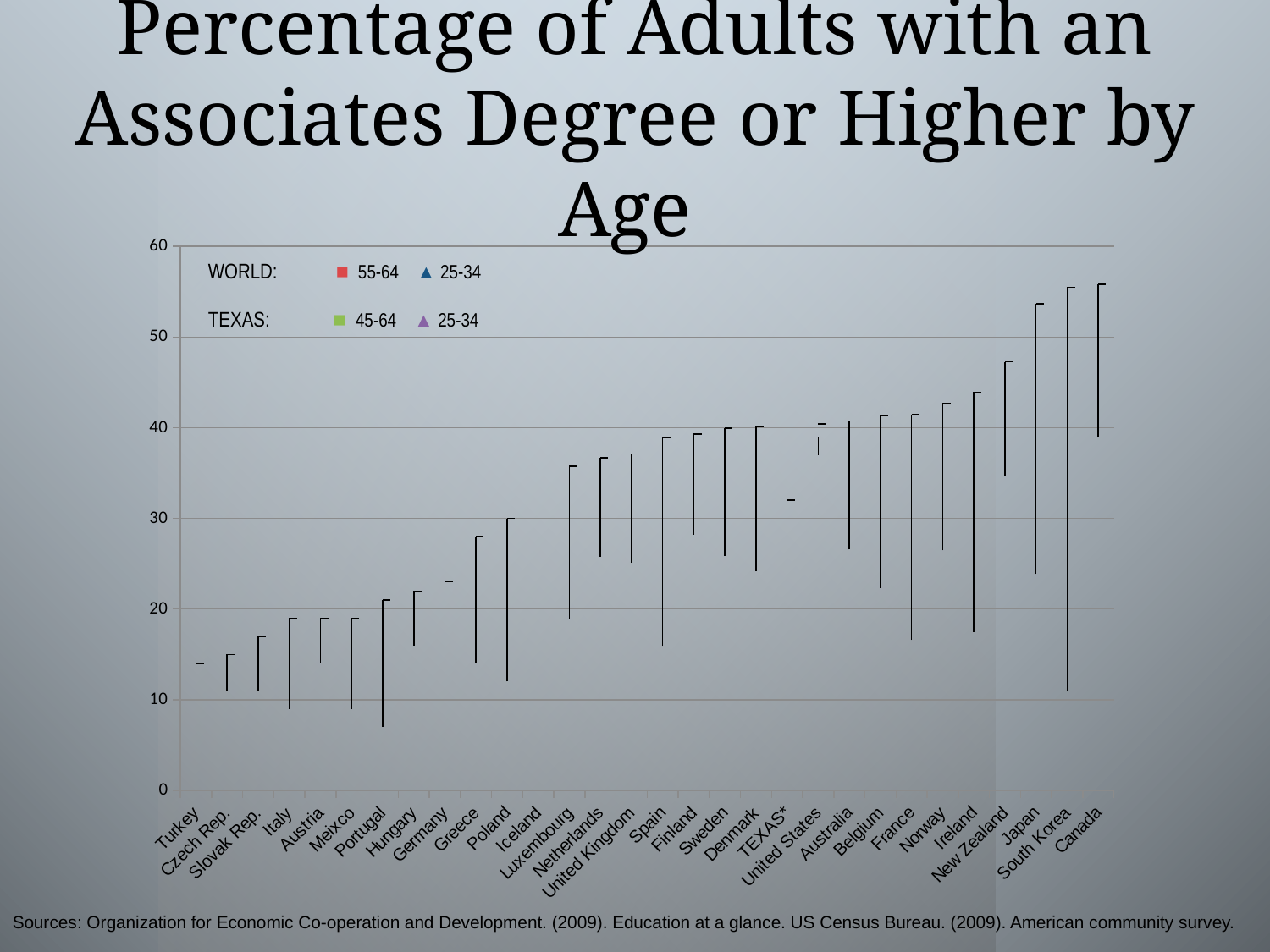
Is the highest value shown for Canada greater or less than 50? greater Which two age groups does the legend list under TEXAS? 45-64 and 25-34 How many countries or regions are listed along the x axis of the chart? 30 What is the title of the chart? Percentage of Adults with an Associates Degree or Higher by Age How many series entries does the chart's legend list? 4 Are the values shown for TEXAS* greater or less than 40? less Is the lowest value shown for Turkey greater or less than 10? less